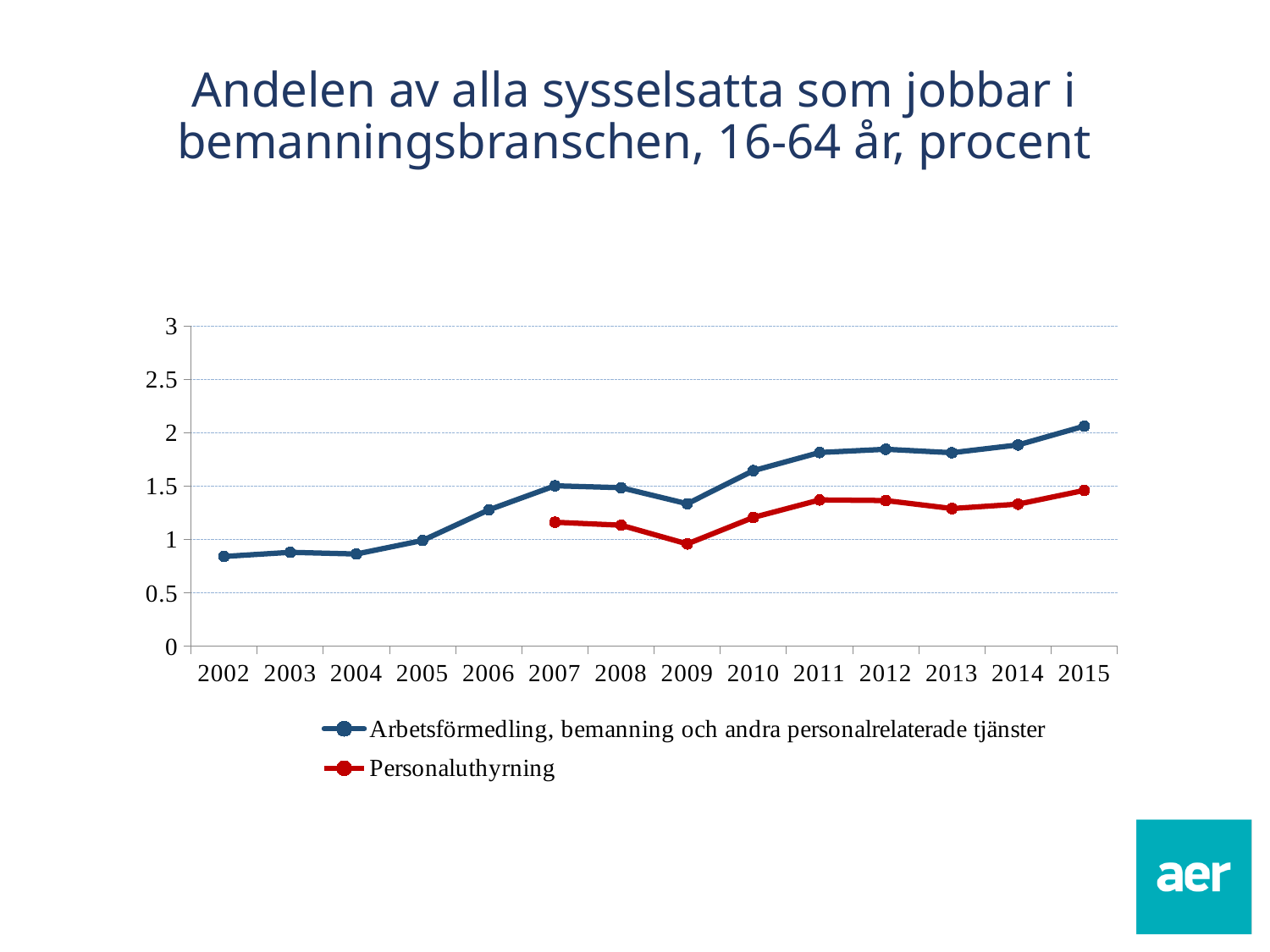
Is the value for Personaluthyrning in 2011 greater or less than 1.5? less Is the value for Arbetsförmedling, bemanning och andra personalrelaterade tjänster in 2011 greater or less than 1.5? greater Is the value for Personaluthyrning in 2007 greater or less than 1? greater In which year does the Personaluthyrning series reach its lowest value? 2009 What type of chart is shown on the slide? line chart How many series does the legend list? 2 In which year does the Personaluthyrning series reach its highest value? 2015 In 2010, which series has the larger value: Arbetsförmedling, bemanning och andra personalrelaterade tjänster or Personaluthyrning? Arbetsförmedling, bemanning och andra personalrelaterade tjänster How many years are shown on the x axis? 14 Does the Arbetsförmedling, bemanning och andra personalrelaterade tjänster series rise or fall overall from 2002 to 2015? rise In which year does the Arbetsförmedling, bemanning och andra personalrelaterade tjänster series reach its highest value? 2015